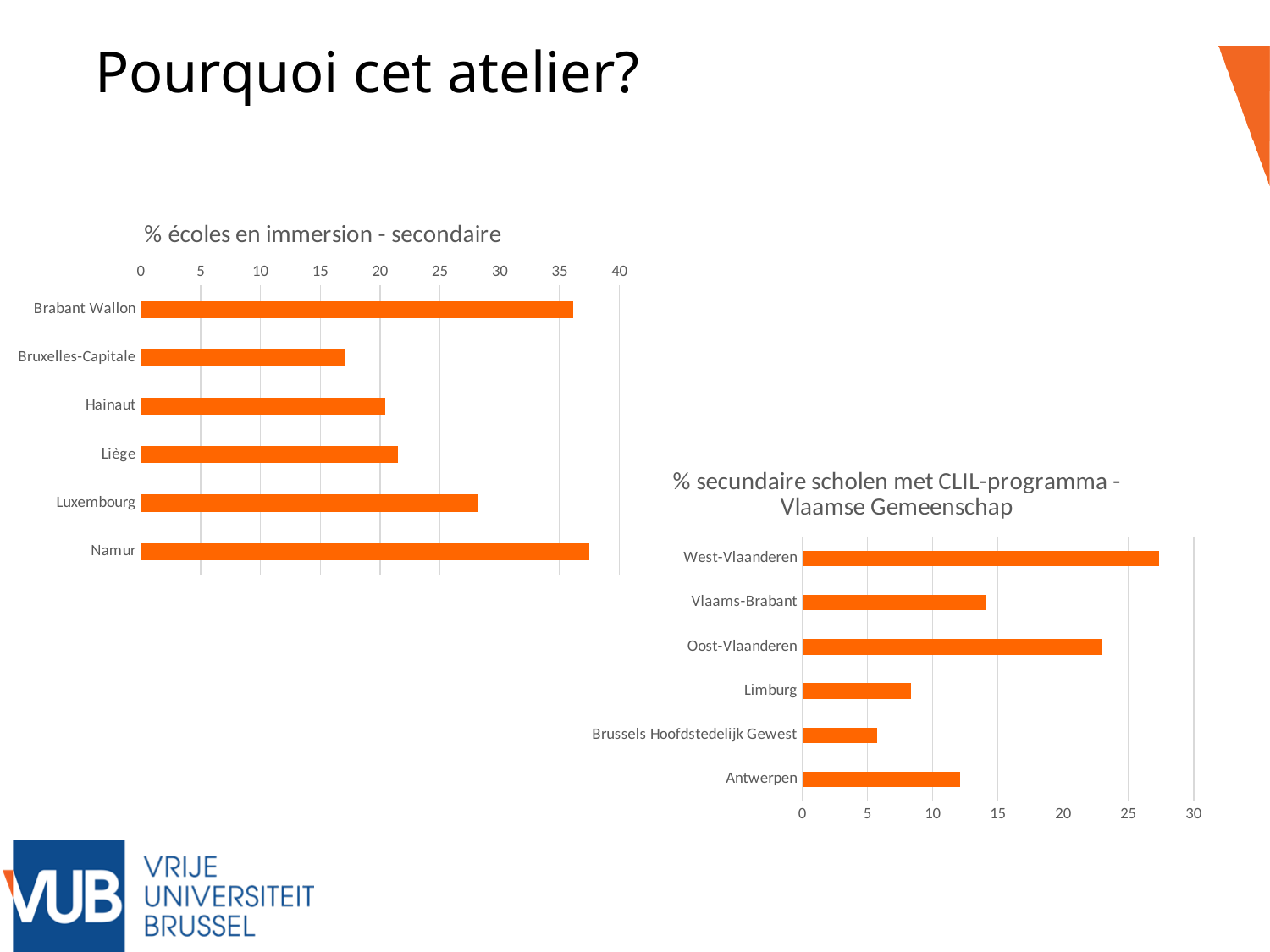
In the '% écoles en immersion - secondaire' chart, is the value for Brabant Wallon greater or less than 30? greater In the '% secundaire scholen met CLIL-programma - Vlaamse Gemeenschap' chart, which category has the lowest value? Brussels Hoofdstedelijk Gewest In the '% secundaire scholen met CLIL-programma - Vlaamse Gemeenschap' chart, which category has the highest value? West-Vlaanderen What is the title of the chart on the right side of the slide? % secundaire scholen met CLIL-programma - Vlaamse Gemeenschap How many categories are shown in the '% écoles en immersion - secondaire' chart? 6 In the '% secundaire scholen met CLIL-programma - Vlaamse Gemeenschap' chart, which is larger, the value for Oost-Vlaanderen or the value for Vlaams-Brabant? Oost-Vlaanderen How many categories are shown in the '% secundaire scholen met CLIL-programma - Vlaamse Gemeenschap' chart? 6 In the '% écoles en immersion - secondaire' chart, which is larger, the value for Luxembourg or the value for Liège? Luxembourg What kind of chart is the '% écoles en immersion - secondaire' chart? bar chart In the '% secundaire scholen met CLIL-programma - Vlaamse Gemeenschap' chart, is the value for Limburg greater or less than 10? less In the '% écoles en immersion - secondaire' chart, is the value for Bruxelles-Capitale greater or less than 20? less In the '% écoles en immersion - secondaire' chart, which category has the lowest value? Bruxelles-Capitale